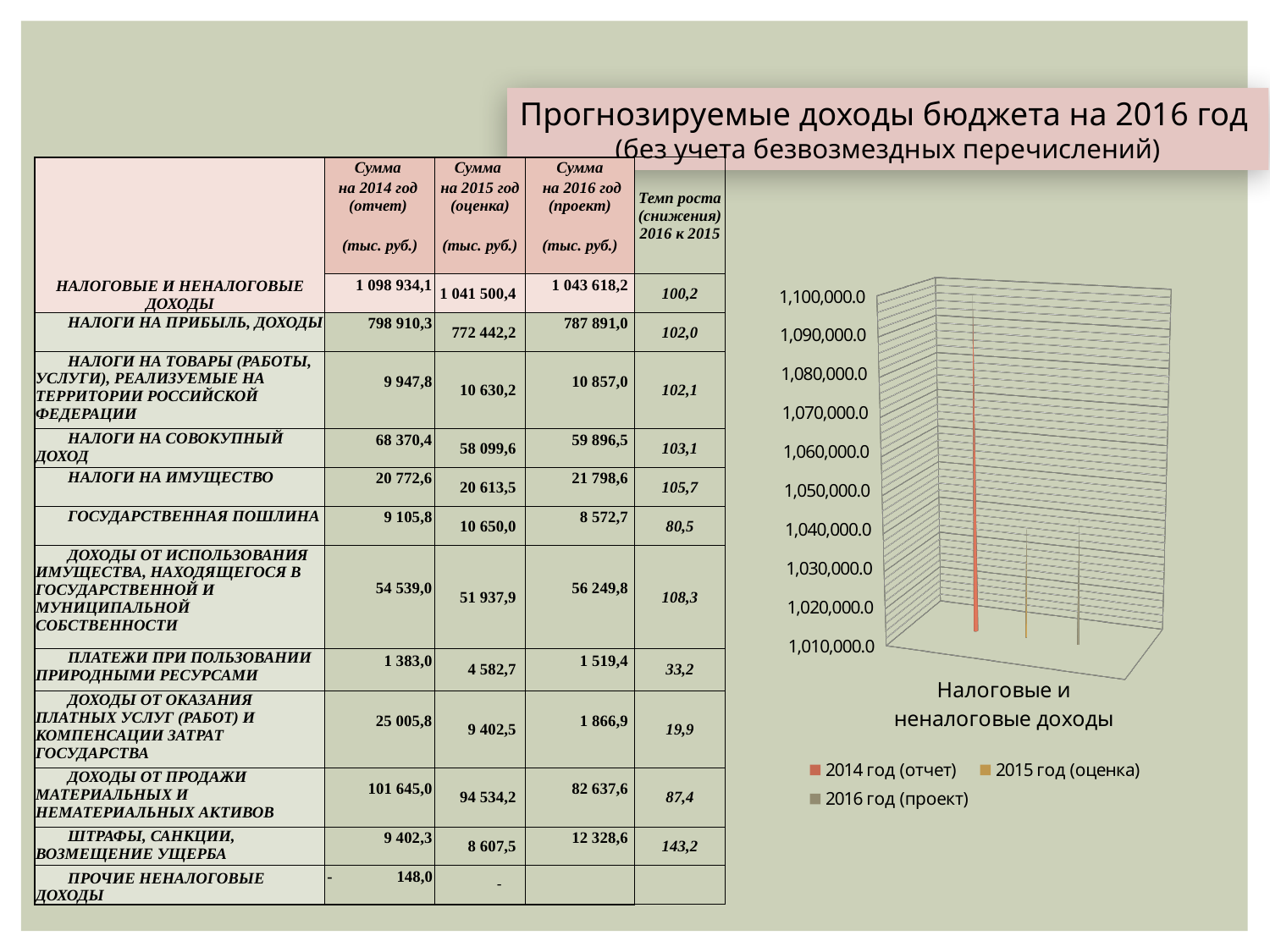
In the chart, which bar is taller: 2014 год (отчет) or 2015 год (оценка)? 2014 год (отчет) Is the value for 2014 год (отчет) in the chart greater or less than 1,050,000.0? greater Is the value for 2016 год (проект) in the chart greater or less than 1,070,000.0? less What kind of chart is shown on the right side of the slide? bar chart How many categories are plotted along the x axis of the chart? 1 What is the category label shown under the bars of the chart? Налоговые и неналоговые доходы What is the highest tick value shown on the vertical axis of the chart? 1,100,000.0 Is the value for 2015 год (оценка) in the chart greater or less than 1,060,000.0? less How many series does the legend of the chart list? 3 Which series has the tallest bar in the chart? 2014 год (отчет) In the chart, which bar is taller: 2014 год (отчет) or 2016 год (проект)? 2014 год (отчет)